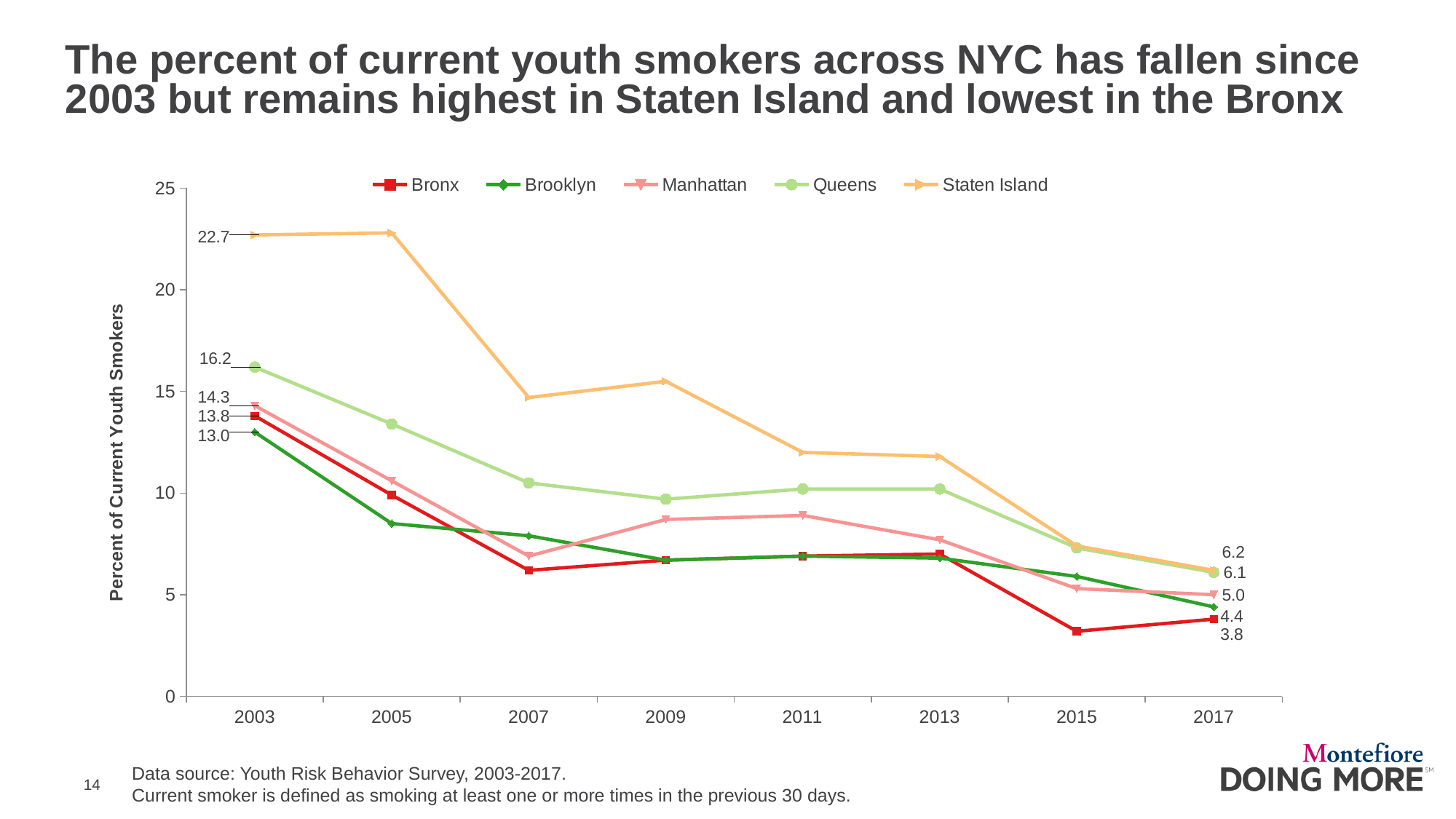
What was the percent of current youth smokers in Queens in 2003? 16.2 Which borough had the highest percent of current youth smokers in 2003? Staten Island What was the percent of current youth smokers in the Bronx in 2017? 3.8 How many series does the legend list? 5 How many years are shown on the x axis? 8 What is the difference between the Staten Island and Brooklyn values in 2003? 9.7 Is the value for Staten Island in 2007 greater or less than 10? greater In 2003, which was higher: the Bronx value or the Brooklyn value? Bronx What was the percent of current youth smokers in Manhattan in 2017? 5.0 What kind of chart is shown on the slide? Line chart Which borough had the lowest percent of current youth smokers in 2017? Bronx What was the percent of current youth smokers in Staten Island in 2003? 22.7